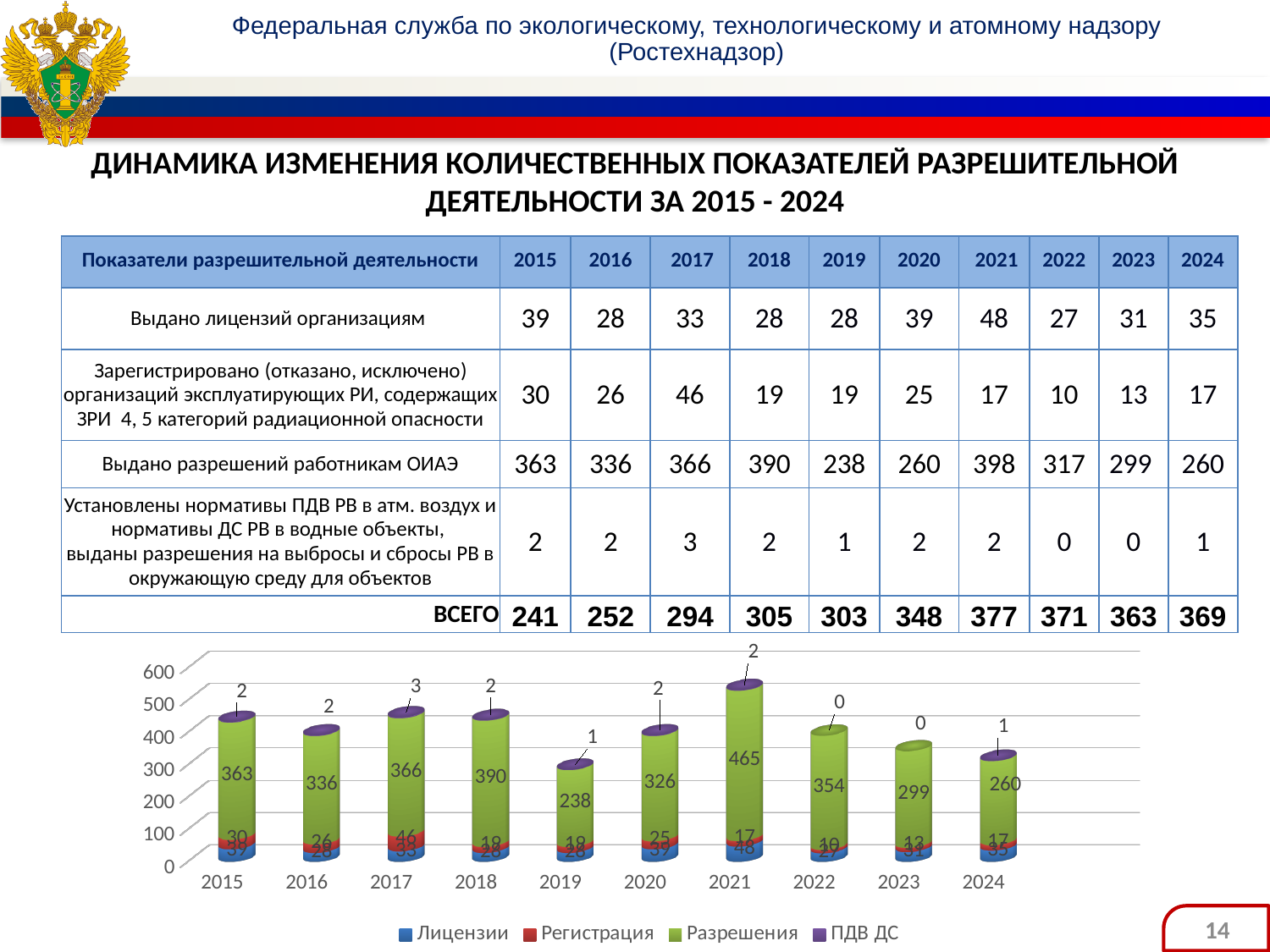
In the chart, what is the value of the ПДВ ДС series for 2023? 0 In the chart, is the Разрешения value larger for 2018 or for 2022? 2018 How many years are shown on the x axis of the chart? 10 In the chart, which year has the highest value for the Разрешения series? 2021 In the chart, which year has the lowest value for the Разрешения series? 2019 In the chart, which series is shown in green? Разрешения In the chart, what is the value of the Разрешения series for 2019? 238 What kind of chart is shown on the slide? bar chart In the chart, what is the difference between the Разрешения values for 2021 and 2024? 205 In the chart, what is the value of the Разрешения series for 2021? 465 How many series does the chart legend list? 4 In the chart, what is the value of the ПДВ ДС series for 2017? 3